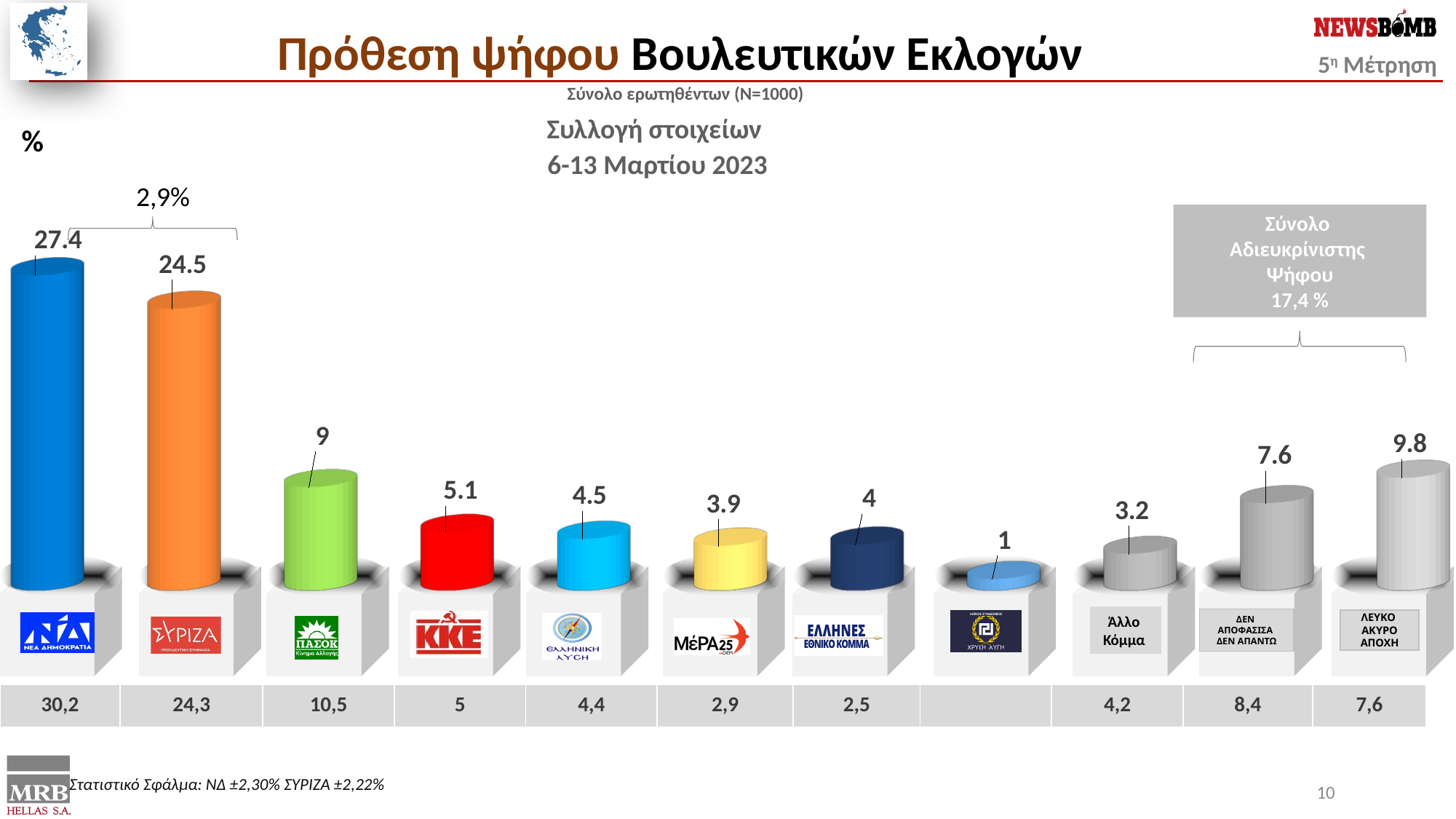
What is the total undecided vote (Σύνολο Αδιευκρίνιστης Ψήφου) shown in the grey box? 17,4 % What kind of chart is shown on the slide? bar chart Which is larger, the value for ΕΛΛΗΝΙΚΗ ΛΥΣΗ or the value for ΜέΡΑ25? ΕΛΛΗΝΙΚΗ ΛΥΣΗ What is the difference between the values for ΝΕΑ ΔΗΜΟΚΡΑΤΙΑ and ΣΥΡΙΖΑ? 2.9 What is the value shown for ΚΚΕ? 5.1 What is the value shown for ΝΕΑ ΔΗΜΟΚΡΑΤΙΑ? 27.4 What is the value shown for ΛΕΥΚΟ ΑΚΥΡΟ ΑΠΟΧΗ? 9.8 Which category has the lowest value in the chart? ΧΡΥΣΗ ΑΥΓΗ What is the value shown for ΠΑΣΟΚ? 9 How many bars are shown in the chart? 11 What is the value shown for ΣΥΡΙΖΑ? 24.5 Which party has the highest value in the chart? ΝΕΑ ΔΗΜΟΚΡΑΤΙΑ